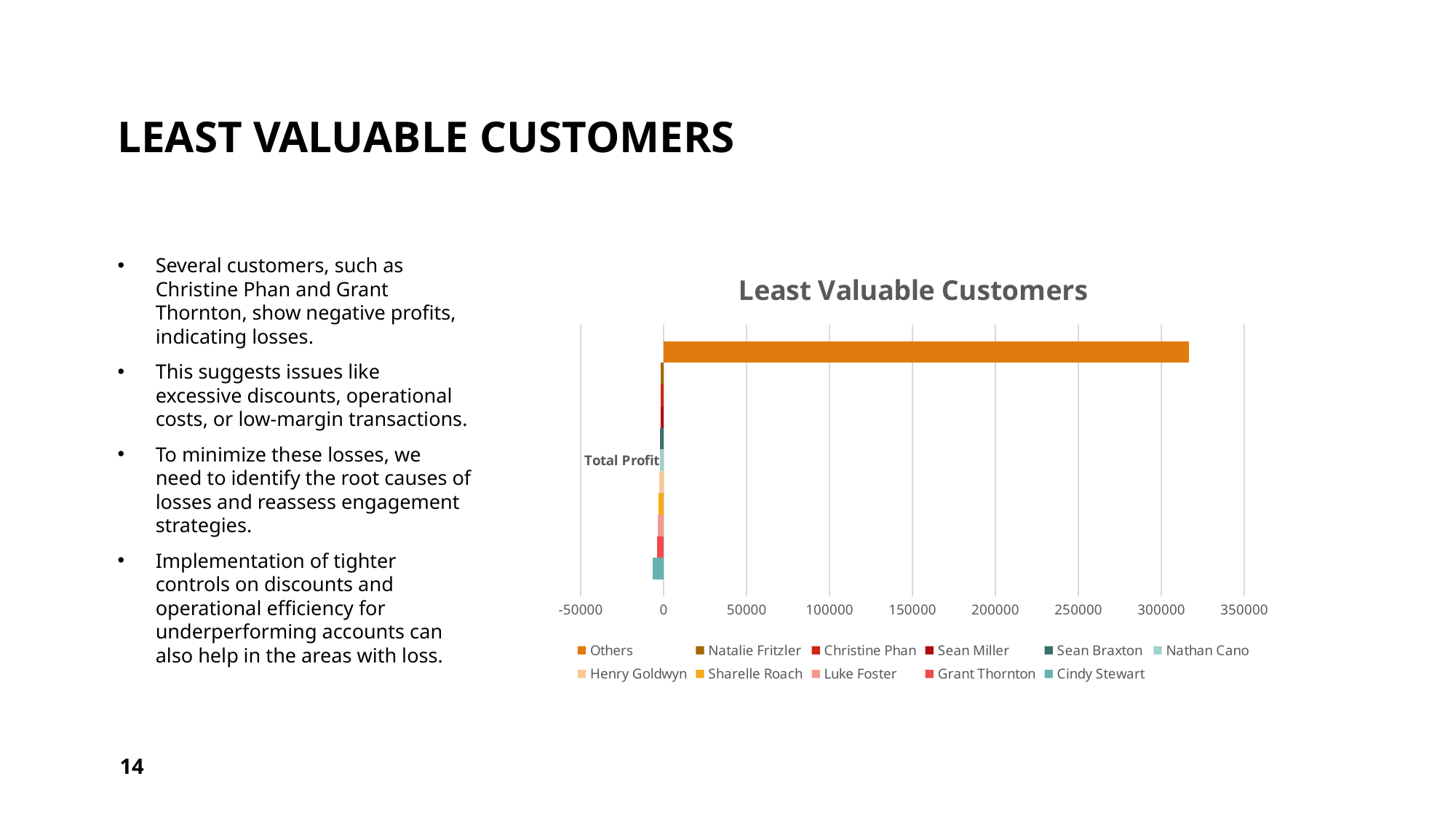
How many categories are shown on the vertical axis of the chart? 1 Which is larger, the Total Profit for Others or for Cindy Stewart? Others What kind of chart is shown on the slide? Bar chart Which series has the lowest Total Profit value? Cindy Stewart What is the title of the chart? Least Valuable Customers How many series does the chart legend list? 11 Is the Total Profit value for Others greater or less than 300000? greater Is the Total Profit value for Others greater or less than 350000? less What is the label of the single category on the vertical axis? Total Profit Which series has the highest Total Profit value? Others What is the lowest value shown on the horizontal axis? -50000 Is the Total Profit value for Cindy Stewart greater or less than 0? less